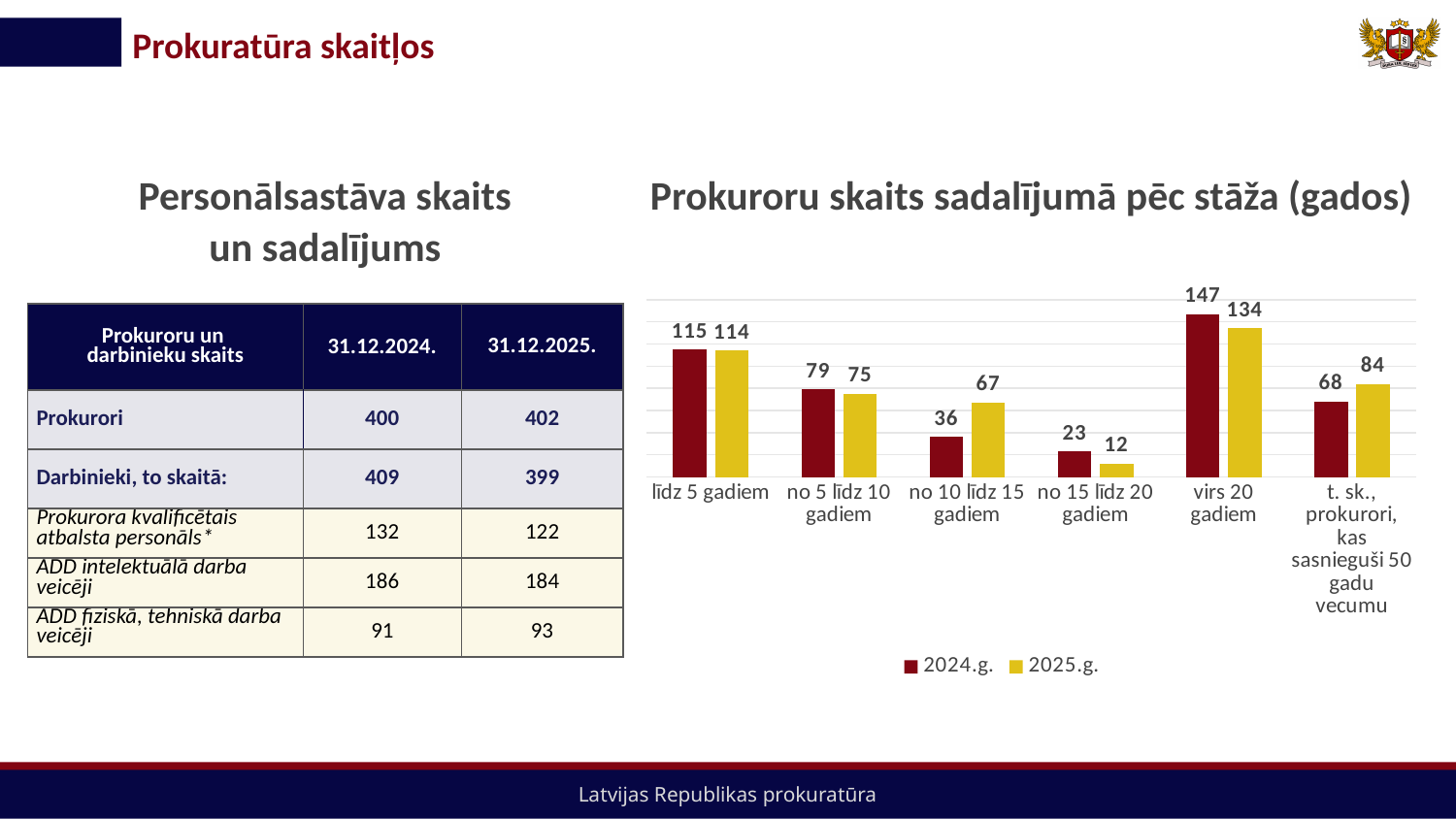
What is the 2024.g. value for "virs 20 gadiem"? 147 Which category has the lowest 2025.g. value? no 15 līdz 20 gadiem What is the 2025.g. value for "no 10 līdz 15 gadiem"? 67 What is the title of the chart? Prokuroru skaits sadalījumā pēc stāža (gados) What is the 2025.g. value for "no 15 līdz 20 gadiem"? 12 Which category has the highest 2024.g. value? virs 20 gadiem What kind of chart is shown on the slide? bar chart How many categories are shown on the x axis of the chart? 6 For "t. sk., prokurori, kas sasnieguši 50 gadu vecumu", which year has the larger value, 2024.g. or 2025.g.? 2025.g. How many series does the chart legend list? 2 What is the difference between the 2025.g. and 2024.g. values for "no 10 līdz 15 gadiem"? 31 What is the difference between the 2024.g. and 2025.g. values for "virs 20 gadiem"? 13